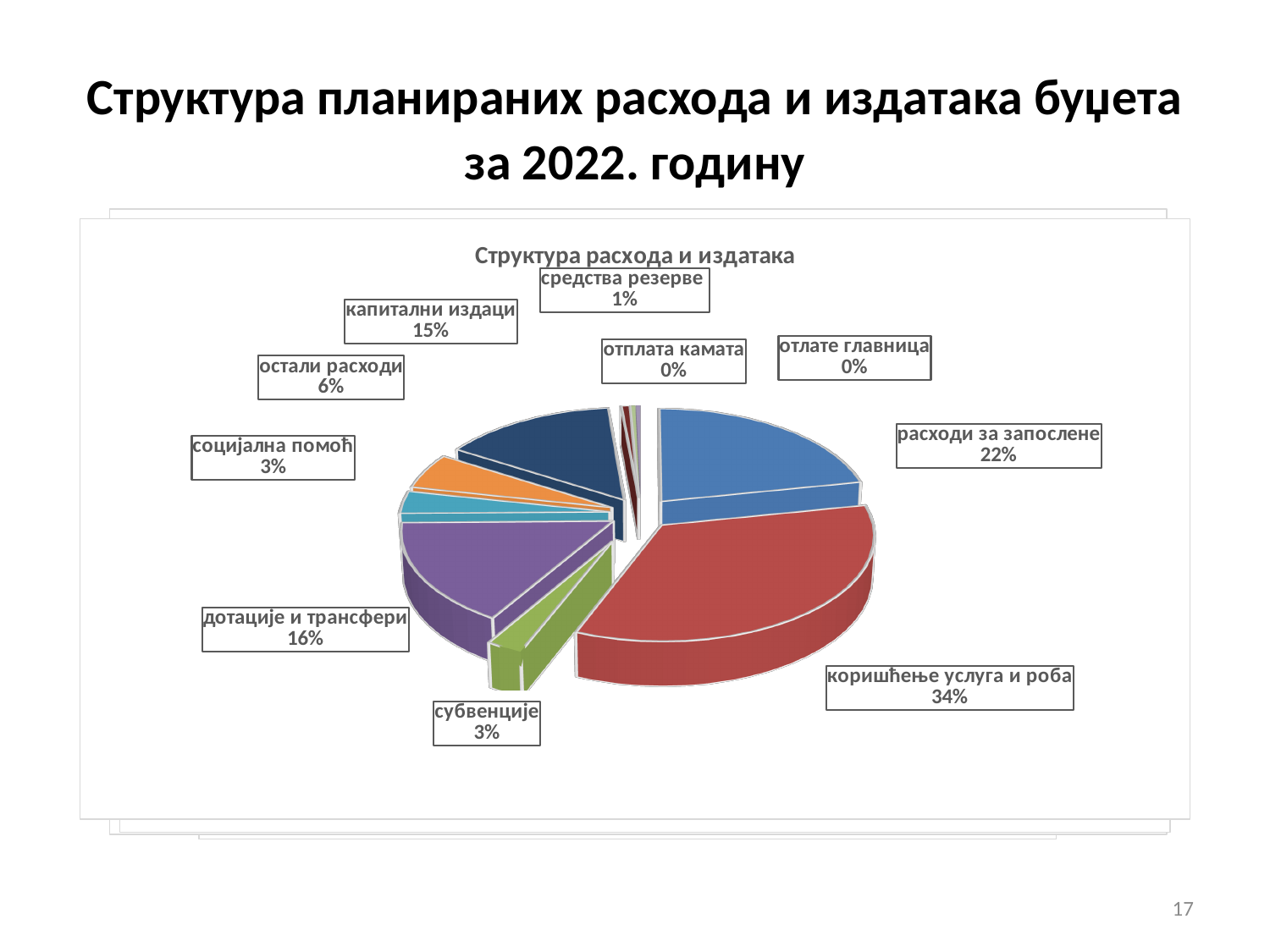
What is the title of the chart? Структура расхода и издатака What is the difference between the shares of коришћење услуга и роба and расходи за запослене? 12% What share of the pie is капитални издаци? 15% What share of the pie is средства резерве? 1% What kind of chart is shown on the slide? pie chart What share of the pie is расходи за запослене? 22% Which category has the largest share of the pie? коришћење услуга и роба Which is larger, the share of дотације и трансфери or the share of капитални издаци? дотације и трансфери How many categories are shown in the pie chart? 10